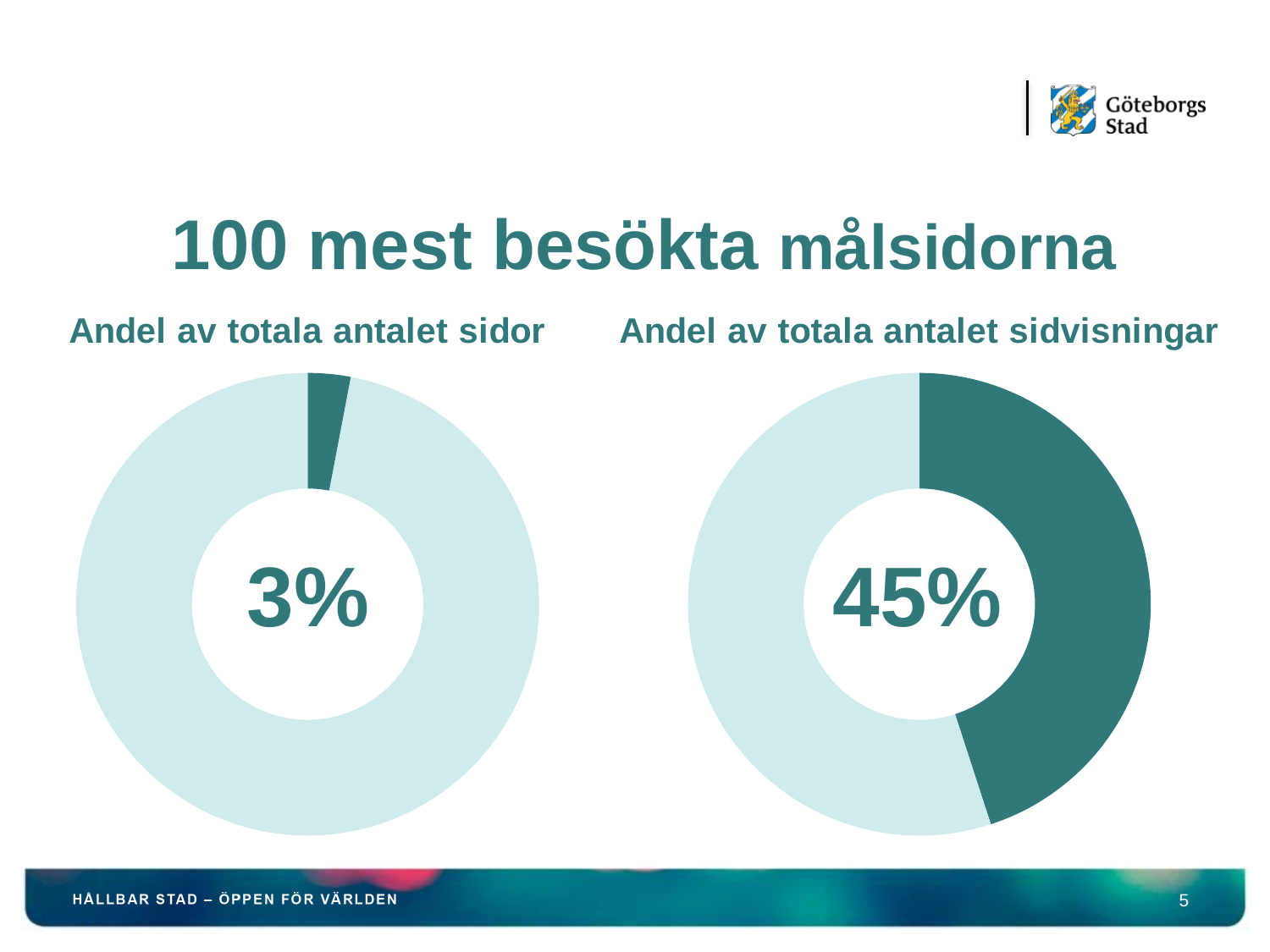
What kind of chart is used on the left side of the slide under "Andel av totala antalet sidor"? Donut (pie) chart What is the title of the chart on the right side of the slide? Andel av totala antalet sidvisningar In the chart titled "Andel av totala antalet sidor", what share of the donut is the dark teal slice? 3% In the chart titled "Andel av totala antalet sidor", what percentage is shown in the centre of the donut? 3% What kind of chart is used on the right side of the slide under "Andel av totala antalet sidvisningar"? Donut (pie) chart Which chart shows the larger highlighted share: "Andel av totala antalet sidor" or "Andel av totala antalet sidvisningar"? Andel av totala antalet sidvisningar What is the main title of the slide above the two charts? 100 mest besökta målsidorna In the chart titled "Andel av totala antalet sidvisningar", what percentage is shown in the centre of the donut? 45% In the chart titled "Andel av totala antalet sidvisningar", what share of the donut is the dark teal slice? 45% How many donut charts are shown on the slide? 2 What is the difference in percentage points between the value in the "Andel av totala antalet sidvisningar" chart and the value in the "Andel av totala antalet sidor" chart? 42 percentage points